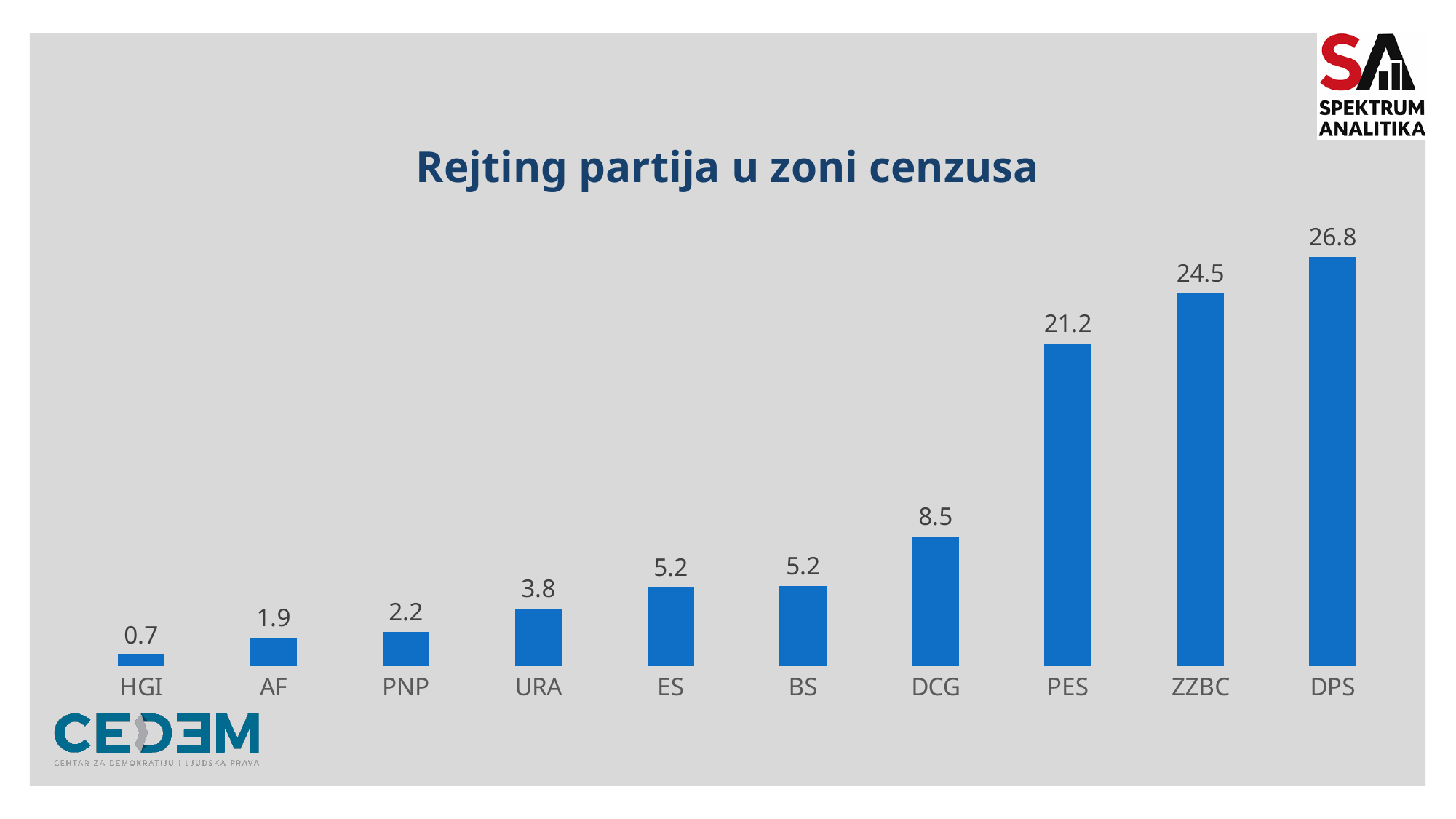
Which category has the lowest value? HGI What is the value for PES? 21.2 What is the difference between the values for DPS and ZZBC? 2.3 What is the title of the chart? Rejting partija u zoni cenzusa Which is larger, the value for AF or the value for PNP? PNP What is the value for DCG? 8.5 What is the value for URA? 3.8 Do the values rise or fall from left to right along the x axis? Rise What kind of chart is shown on the slide? Bar chart Which category has the highest value? DPS How many categories are shown on the chart? 10 What is the difference between the values for PES and DCG? 12.7